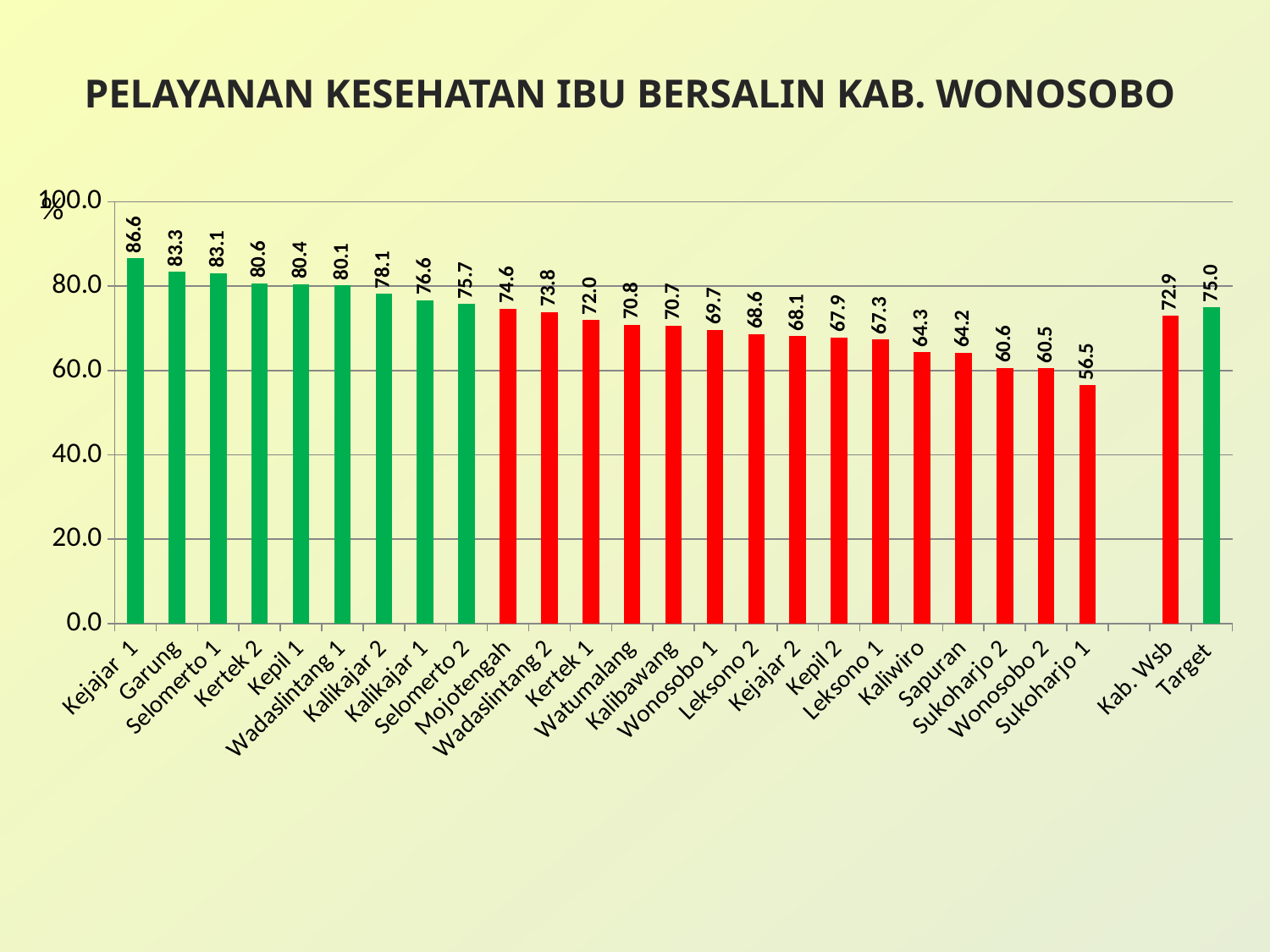
What is the value for Target? 75.0 What kind of chart is shown on the slide? Bar chart Which is larger, the value for Garung or the value for Kaliwiro? Garung Which category has the lowest value? Sukoharjo 1 What is the value for Kejajar 1? 86.6 How many categories are shown on the x axis? 26 What is the difference between the Target value and the Kab. Wsb value? 2.1 Which category has the highest value? Kejajar 1 What colour are the bars for the categories from Mojotengah to Sukoharjo 1? Red What is the value for Mojotengah? 74.6 What is the value for Kab. Wsb? 72.9 What is the difference between the values for Kejajar 1 and Sukoharjo 1? 30.1